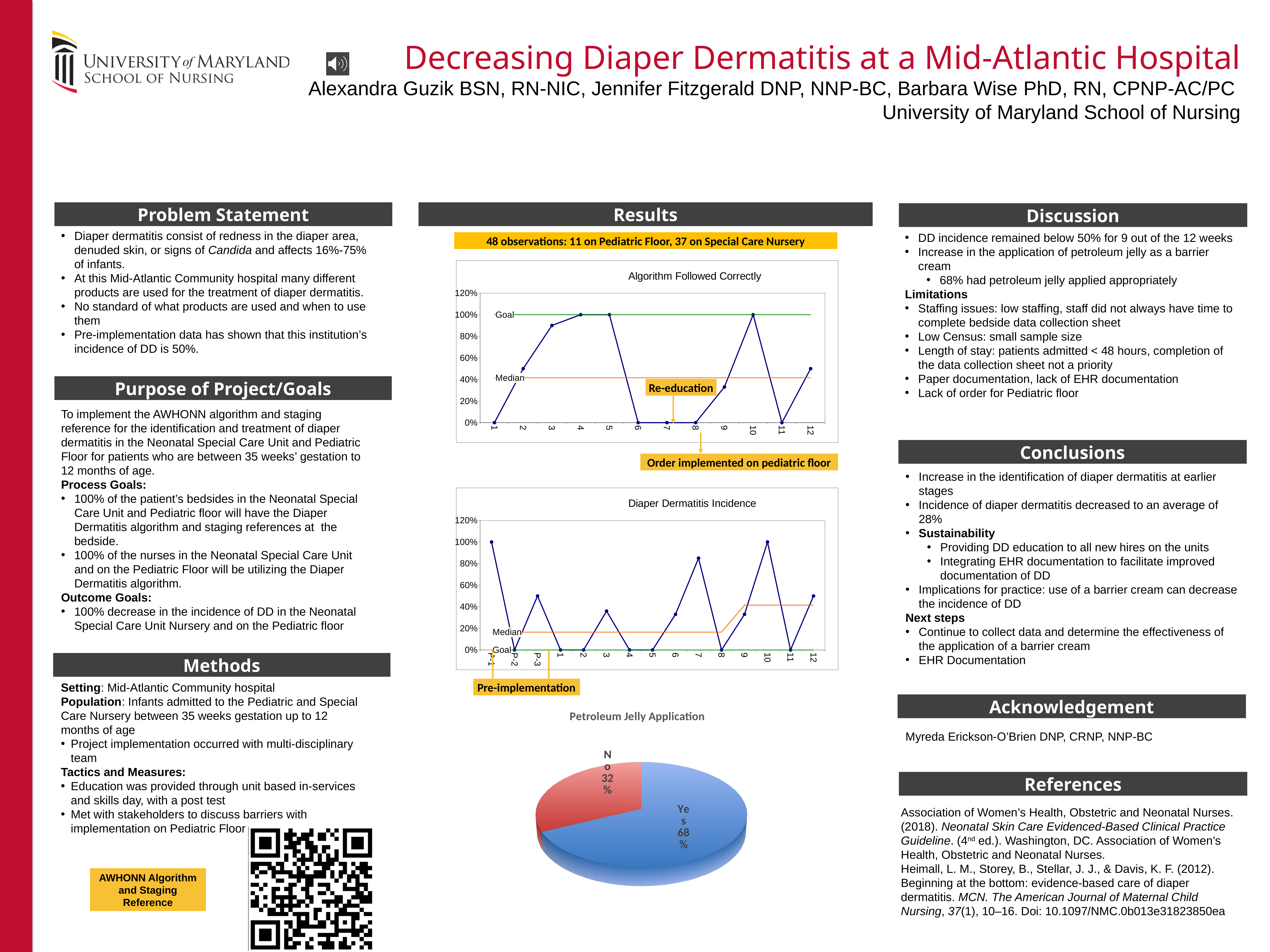
In the Petroleum Jelly Application pie chart, what share of observations is labelled No? 32% In the Petroleum Jelly Application pie chart, what share of observations is labelled Yes? 68% In the Algorithm Followed Correctly chart, how many weeks are plotted on the x axis? 12 In the Algorithm Followed Correctly chart, what is the value at week 4? 100% In the Diaper Dermatitis Incidence chart, what is the value at P-1? 100% In the Petroleum Jelly Application chart, which slice is larger, Yes or No? Yes What kind of chart is the Algorithm Followed Correctly chart? line chart In the Algorithm Followed Correctly chart, is the value for week 3 greater or less than 80%? greater What kind of chart is the Petroleum Jelly Application chart? pie chart In the Algorithm Followed Correctly chart, what is the value at week 1? 0% In the Diaper Dermatitis Incidence chart, how many points are plotted along the x axis? 15 In the Diaper Dermatitis Incidence chart, is the value for week 7 greater or less than 60%? greater